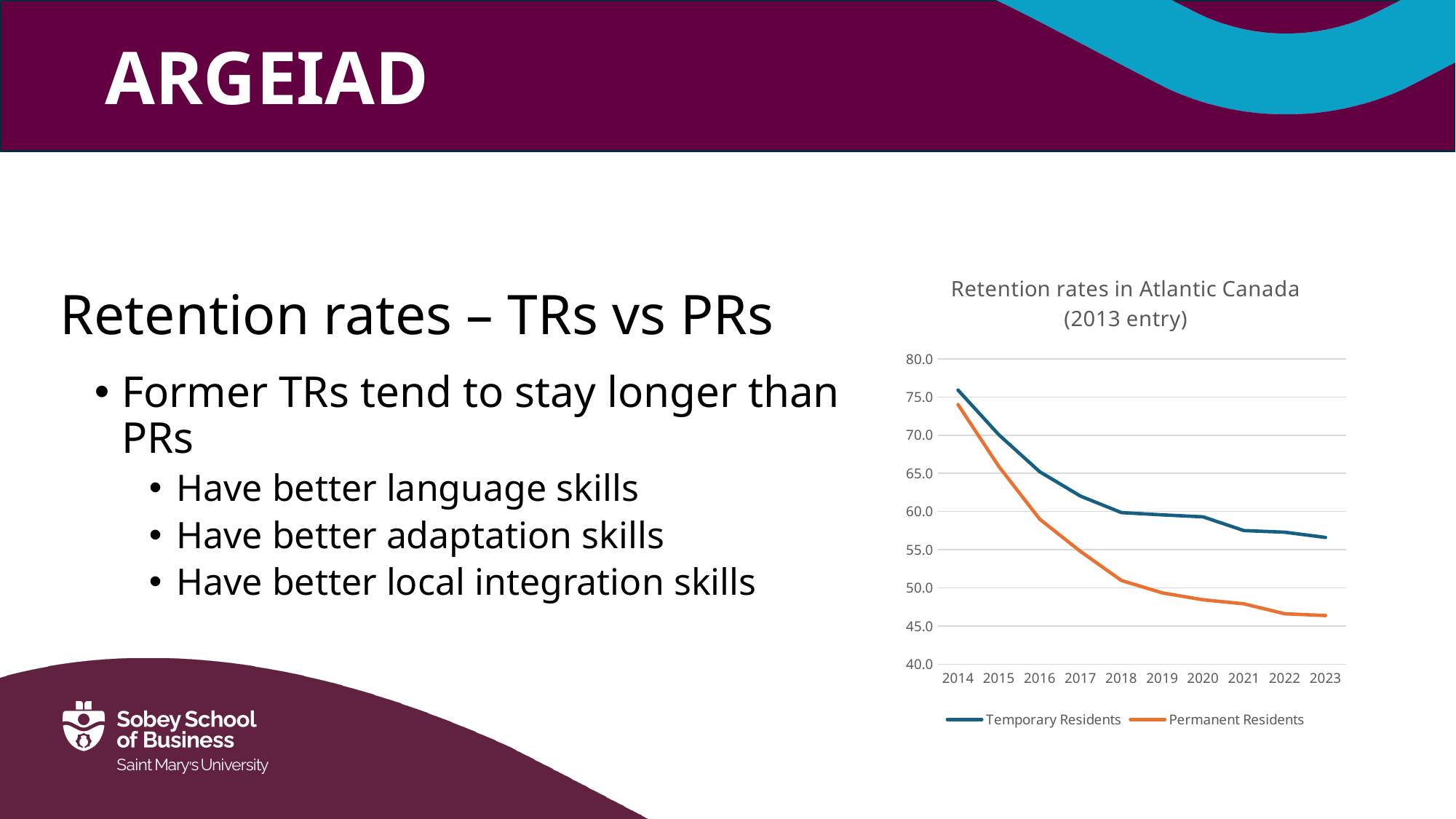
Do the retention rates for Temporary Residents rise or fall from 2014 to 2023? fall How many years are shown on the x axis of the chart? 10 Do the retention rates for Permanent Residents rise or fall from 2014 to 2023? fall What is the title of the chart on the slide? Retention rates in Atlantic Canada (2013 entry) Which series is drawn in orange in the chart? Permanent Residents In which year is the Temporary Residents retention rate highest? 2014 Is the Permanent Residents retention rate in 2023 greater or less than 50.0? less In 2023, which series has the higher retention rate, Temporary Residents or Permanent Residents? Temporary Residents Is the Permanent Residents retention rate in 2014 greater or less than 70.0? greater What kind of chart is shown on the slide? line chart How many series does the chart's legend list? 2 Is the Temporary Residents retention rate in 2023 greater or less than 55.0? greater